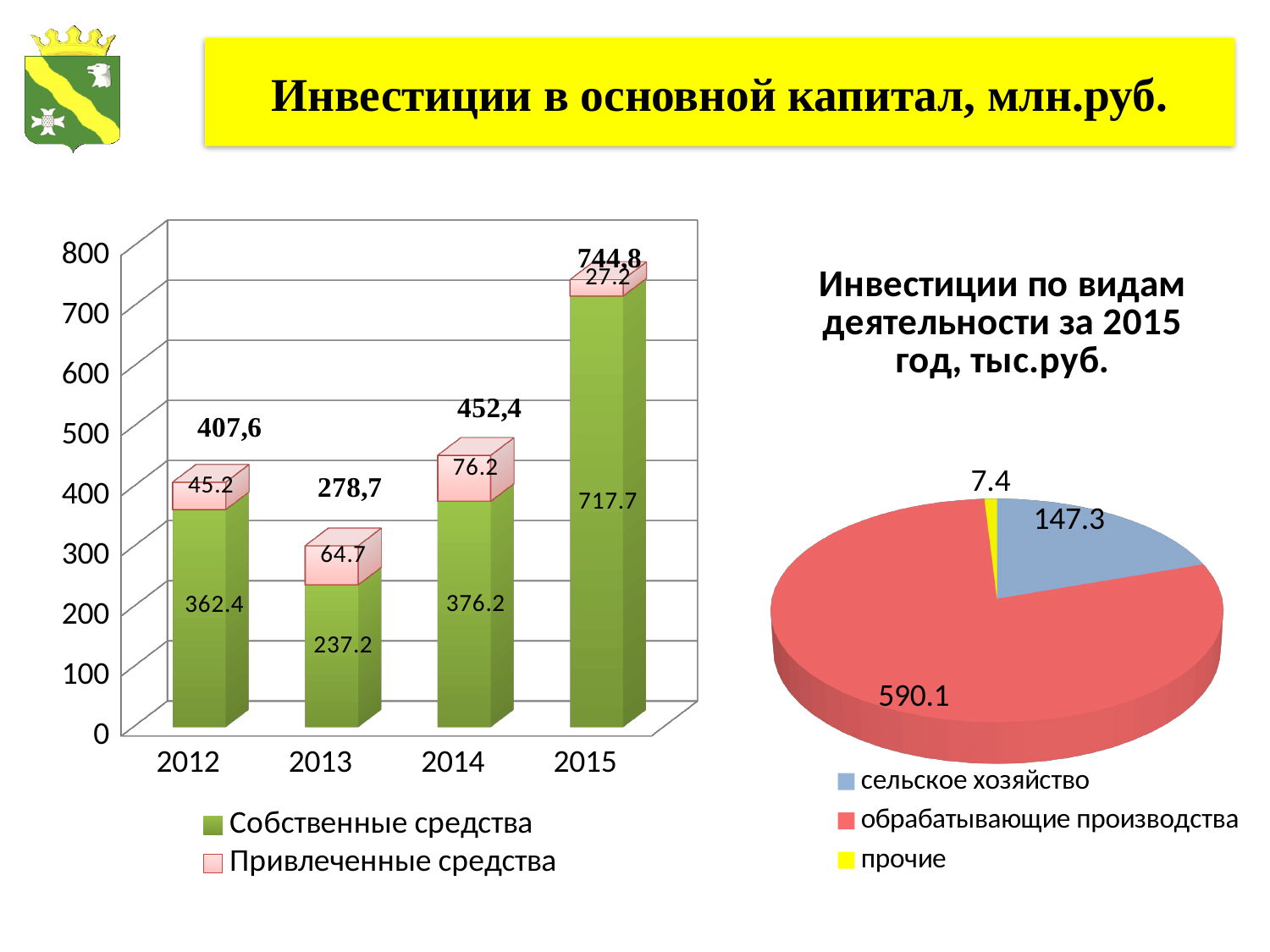
In the bar chart on the left, which is larger: Привлеченные средства in 2013 or in 2012? 2013 In the bar chart on the left, which year has the lowest value of Привлеченные средства? 2015 In the bar chart on the left, what is the value of Привлеченные средства for 2014? 76.2 What type of chart is shown on the right side of the slide? pie chart In the bar chart on the left, how many years are shown on the x axis? 4 In the bar chart on the left, how many series does the legend list? 2 In the bar chart on the left, what total is printed above the 2013 bar? 278,7 In the pie chart on the right, what is the value for обрабатывающие производства? 590.1 In the bar chart on the left, which year has the highest value of Собственные средства? 2015 In the bar chart on the left, what is the value of Собственные средства for 2015? 717.7 In the pie chart on the right, which category has the smallest slice? прочие In the bar chart on the left, what is the difference between Собственные средства in 2014 and in 2013? 139.0